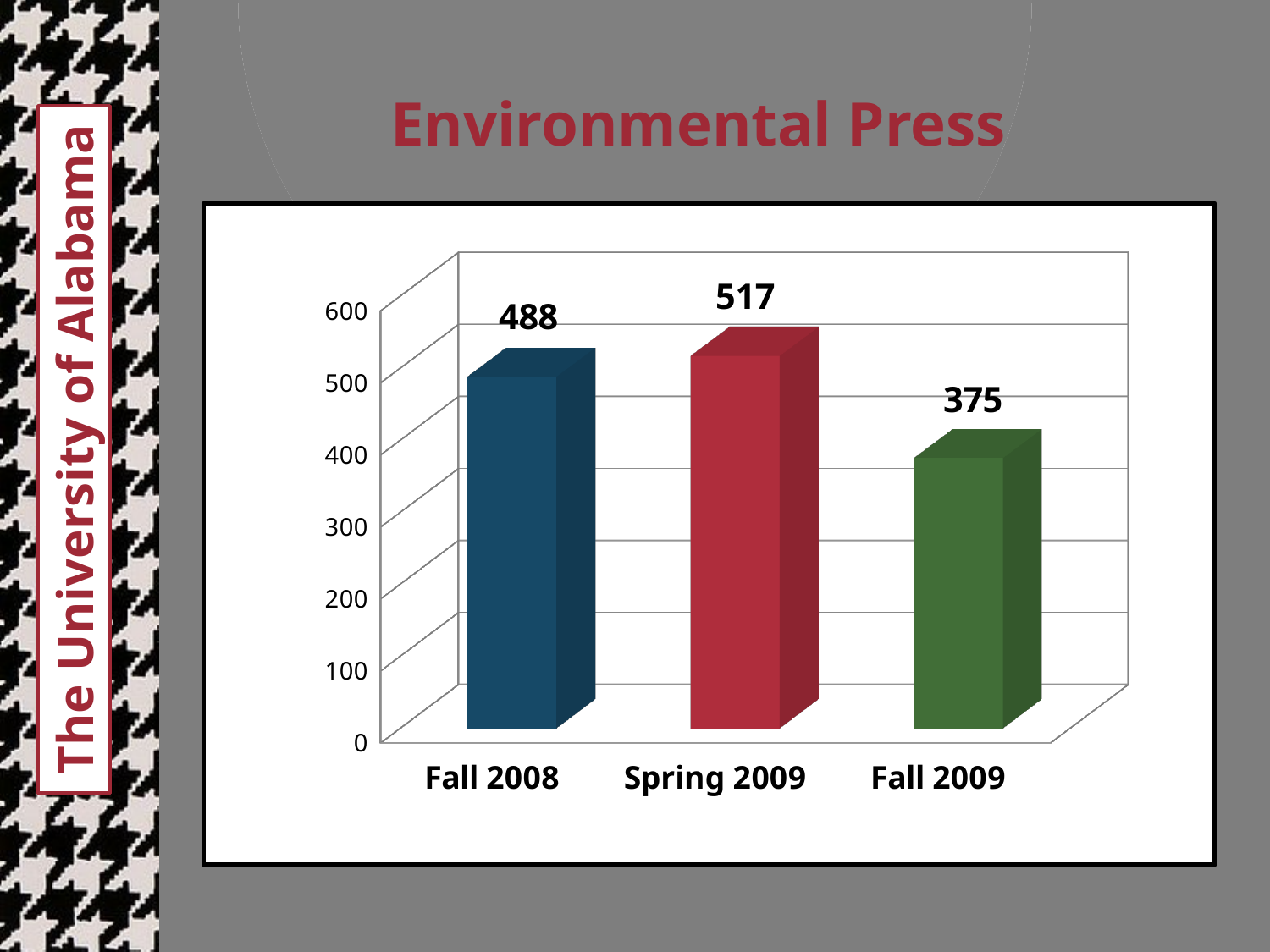
Which is larger, the value for Fall 2008 or the value for Fall 2009? Fall 2008 Is the value for Fall 2009 greater or less than 400? less What is the value for Fall 2009? 375 What is the value for Spring 2009? 517 What is the difference between the values for Spring 2009 and Fall 2008? 29 Which category has the lowest value? Fall 2009 How many categories are shown on the x axis? 3 What is the value for Fall 2008? 488 What is the difference between the values for Spring 2009 and Fall 2009? 142 What is the title of the slide above the chart? Environmental Press What kind of chart is shown on the slide? bar chart Which category has the highest value? Spring 2009